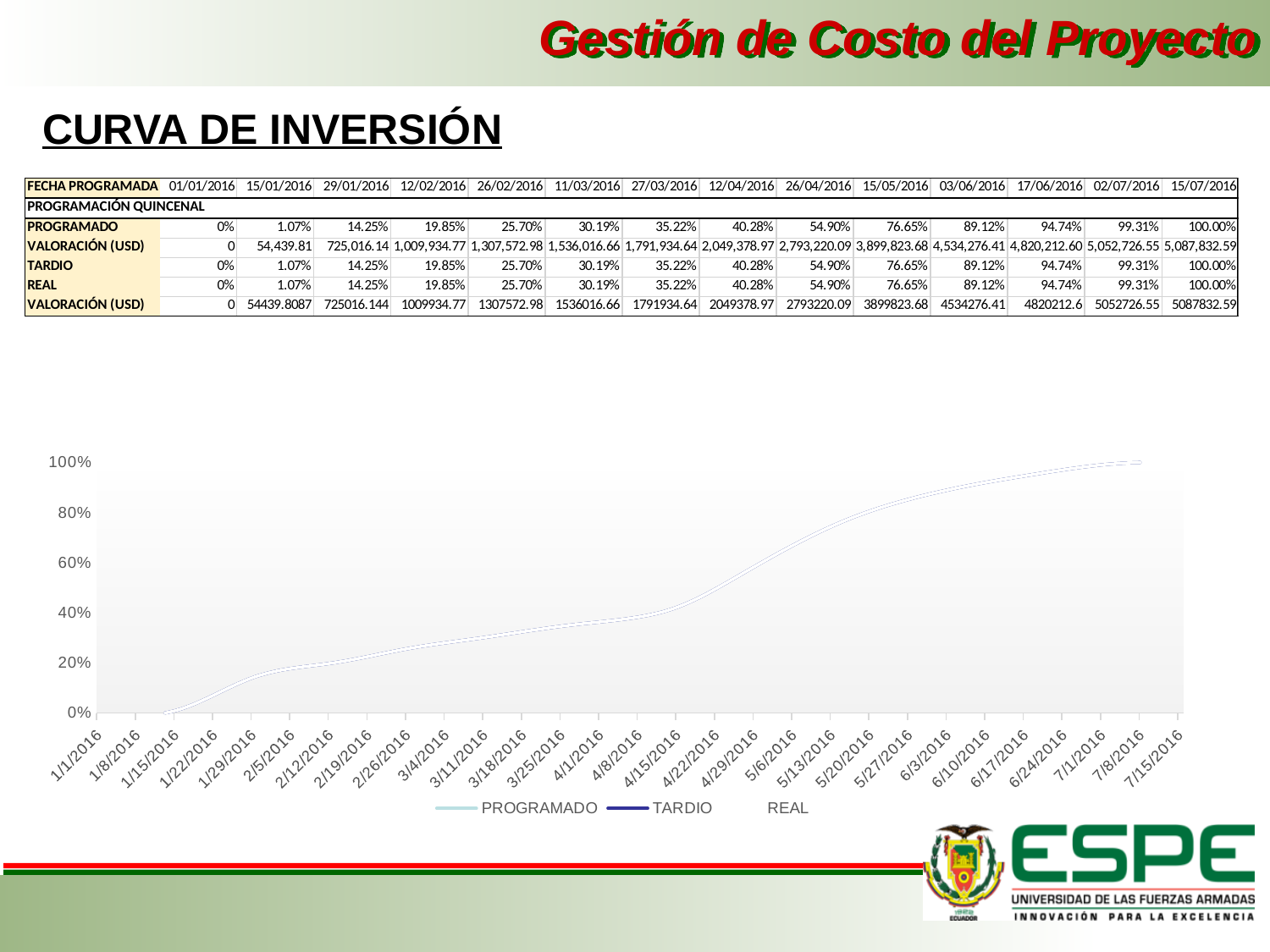
How many series does the chart legend list? 3 According to the table, what is the PROGRAMADO percentage on 15/05/2016? 76.65% According to the table, what is the REAL percentage on 15/07/2016? 100.00% Is the plotted value at 5/6/2016 greater or less than 40%? greater Do the plotted values rise or fall from 1/1/2016 to 7/15/2016? Rise Is the plotted value at 2/5/2016 greater or less than 20%? less Which is larger, the PROGRAMADO value on 03/06/2016 or on 26/04/2016? 03/06/2016 What kind of chart is shown on the slide? Line chart According to the table, what is the PROGRAMADO VALORACIÓN (USD) on 12/04/2016? 2,049,378.97 How many scheduled dates (FECHA PROGRAMADA) are listed in the table? 14 What are the series names listed in the chart legend? PROGRAMADO, TARDIO, REAL By how many percentage points does the PROGRAMADO value on 26/04/2016 exceed the value on 12/04/2016? 14.62%